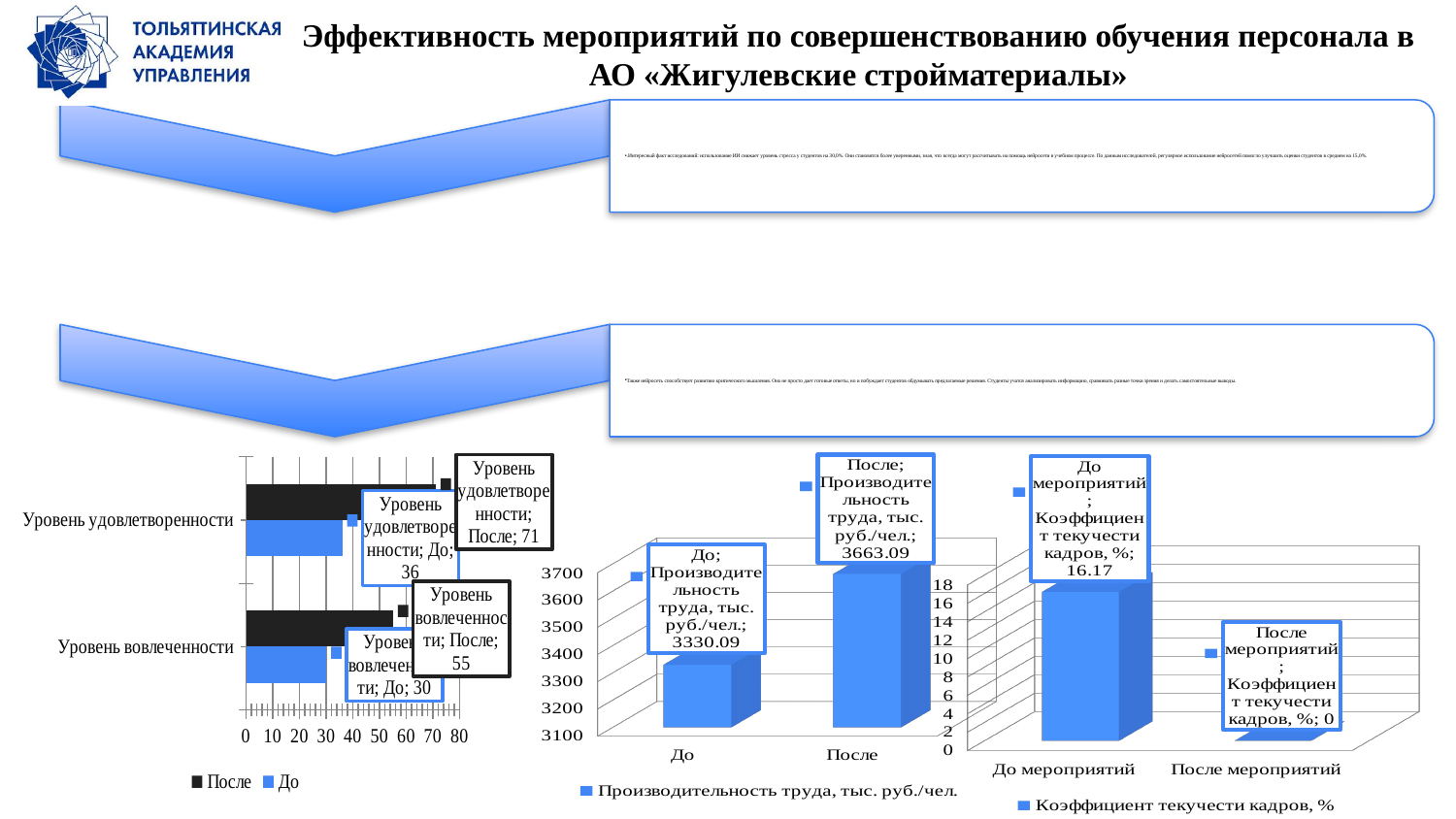
In the middle chart (Производительность труда), which category has the higher value? После In the left chart, what is the value of 'После' for 'Уровень удовлетворенности'? 71 In the left chart, what is the value of 'До' for 'Уровень вовлеченности'? 30 How many categories are shown on the x axis of the right chart (Коэффициент текучести кадров)? 2 In the right chart (Коэффициент текучести кадров), what is the value for 'До мероприятий'? 16.17 In the left chart, what is the difference between 'После' and 'До' for 'Уровень удовлетворенности'? 35 In the right chart (Коэффициент текучести кадров), what is the value for 'После мероприятий'? 0 In the middle chart (Производительность труда), what is the value for 'До'? 3330.09 What kind of chart is the left chart? bar chart How many series does the legend of the left chart list? 2 In the left chart, which is larger for 'Уровень вовлеченности': 'После' or 'До'? После In the middle chart (Производительность труда), what is the value for 'После'? 3663.09